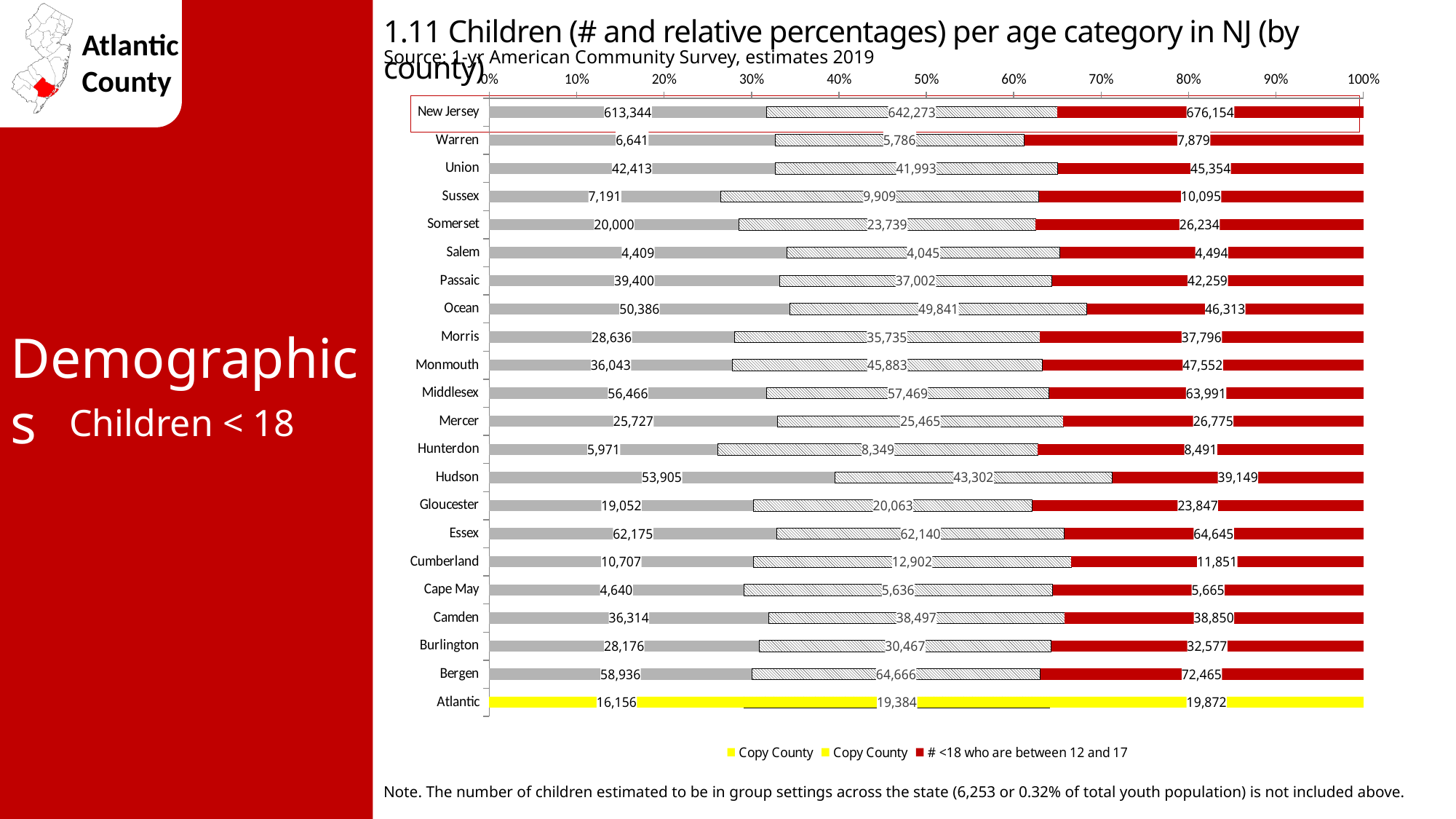
How many series does the legend list? 3 For Hudson, which is larger: the first segment value or the '# <18 who are between 12 and 17' value? The first segment value (53,905) What kind of chart is shown on the slide? Stacked bar chart What is the total of the three segments of the Atlantic bar (16,156 + 19,384 + 19,872)? 55,412 What is the value printed on the first (leftmost) segment of the Hudson bar? 53,905 What is the value of the '# <18 who are between 12 and 17' segment for New Jersey? 676,154 What is the value printed on the first (leftmost) segment of the Atlantic bar? 16,156 Excluding the New Jersey row, which county has the highest '# <18 who are between 12 and 17' value? Bergen How many rows (New Jersey plus counties) are plotted in the chart? 22 Which county's bar is highlighted in yellow? Atlantic For Bergen, what is the difference between the '# <18 who are between 12 and 17' value (72,465) and the first segment value (58,936)? 13,529 Which county has the lowest '# <18 who are between 12 and 17' value? Salem